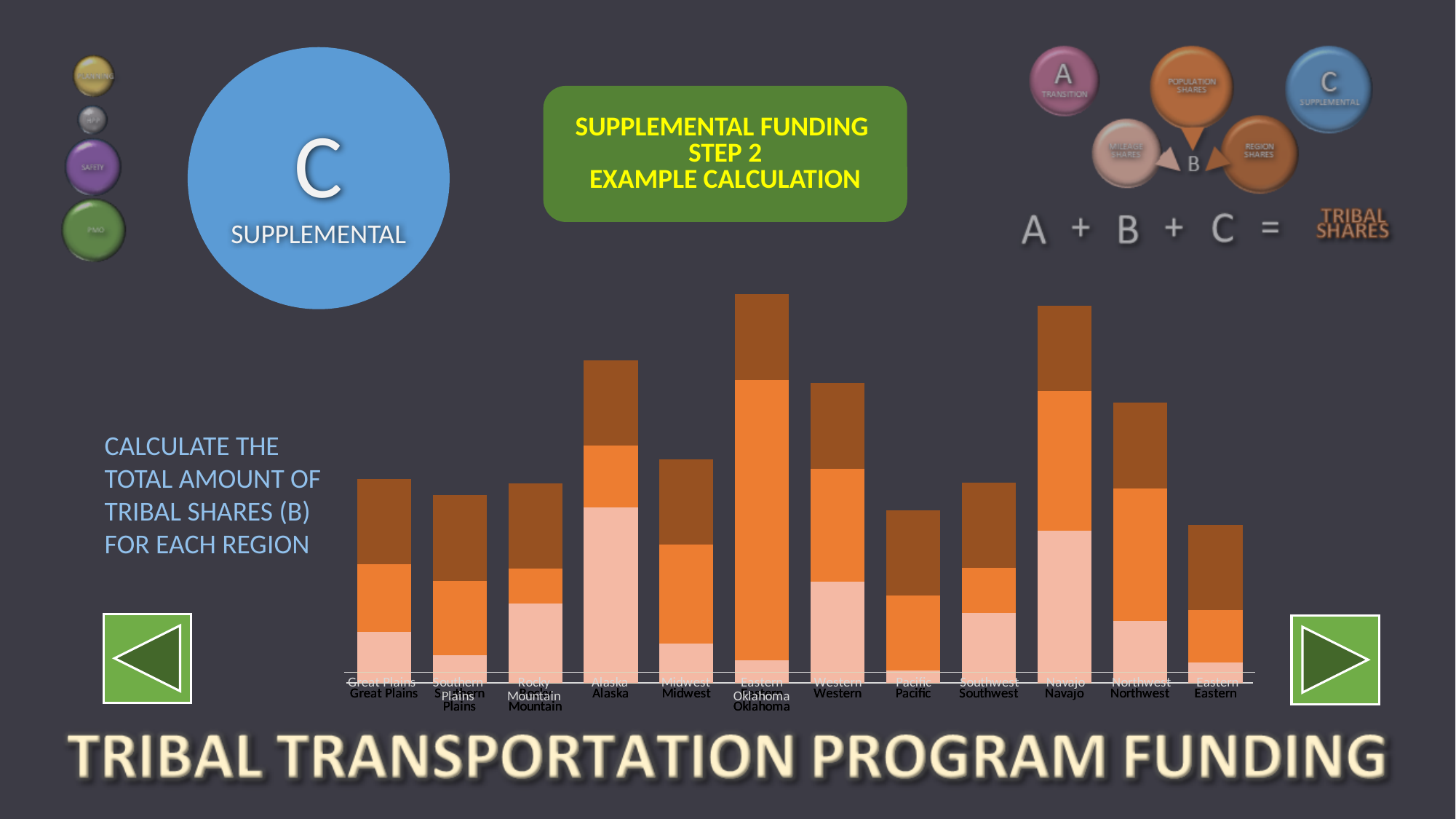
Is the first region listed on the x axis of the chart Great Plains or Eastern? Great Plains Which stacked bar is taller, Pacific or Alaska? Alaska Which stacked bar is taller, Rocky Mountain or Eastern? Rocky Mountain Which region has the tallest stacked bar in the chart? Eastern Oklahoma Which stacked bar is taller, Western or Midwest? Western What kind of chart is shown on the slide? bar chart How many stacked segments does each bar in the chart have? 3 How many regions are shown along the x axis of the chart? 12 Which region has the largest light-pink (bottom) segment in its bar? Alaska